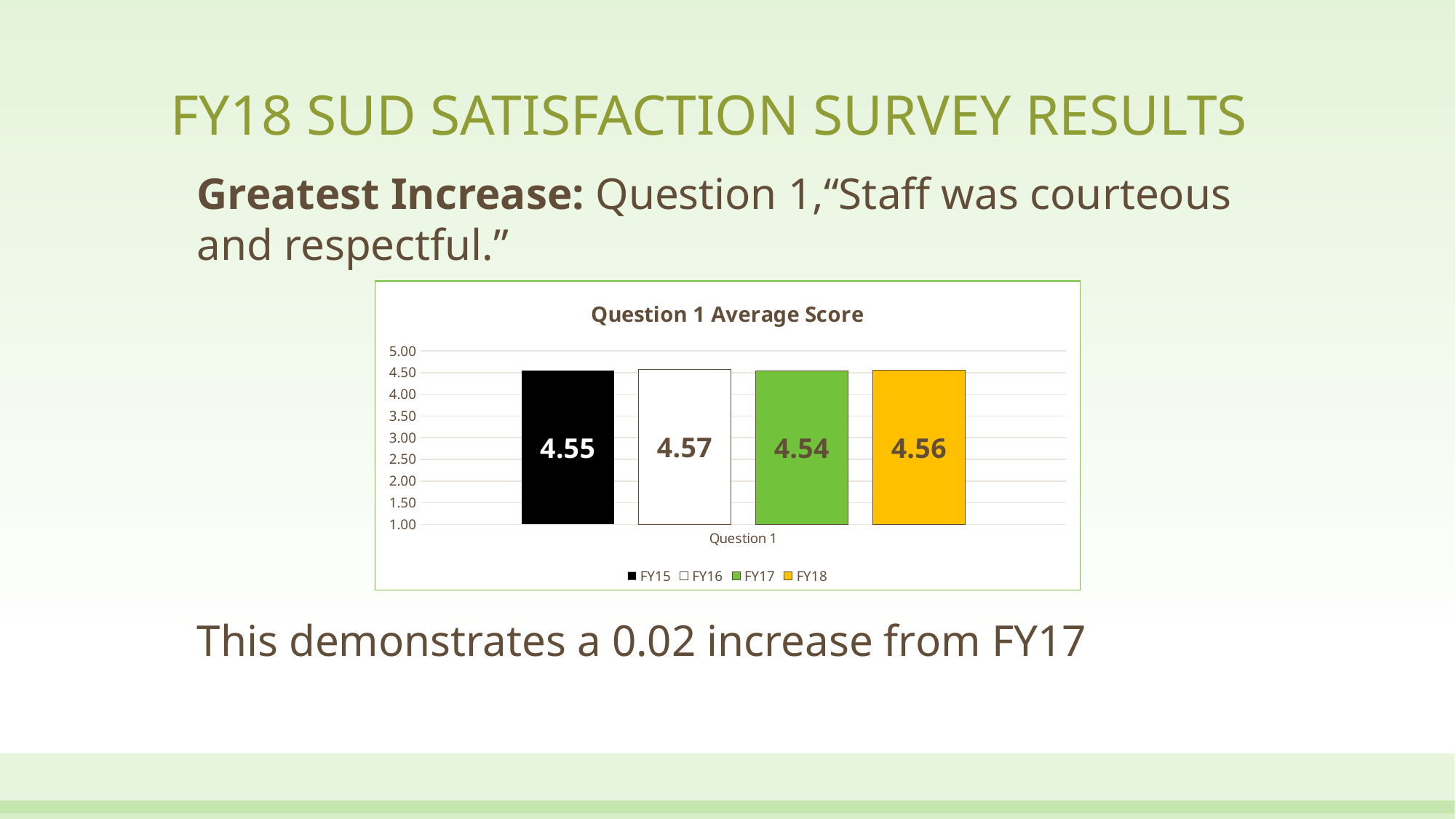
What is the difference between the FY16 and FY15 average scores? 0.02 What kind of chart is shown on the slide? Bar chart What is the FY17 average score for Question 1? 4.54 What is the FY16 average score for Question 1? 4.57 What is the FY15 average score for Question 1? 4.55 Which fiscal year has the lowest Question 1 average score? FY17 What is the FY18 average score for Question 1? 4.56 How many series does the legend list? 4 Which fiscal year has the highest Question 1 average score? FY16 What is the difference between the FY18 and FY17 average scores? 0.02 What colour is the FY18 bar? Yellow/orange What is the title of the chart? Question 1 Average Score